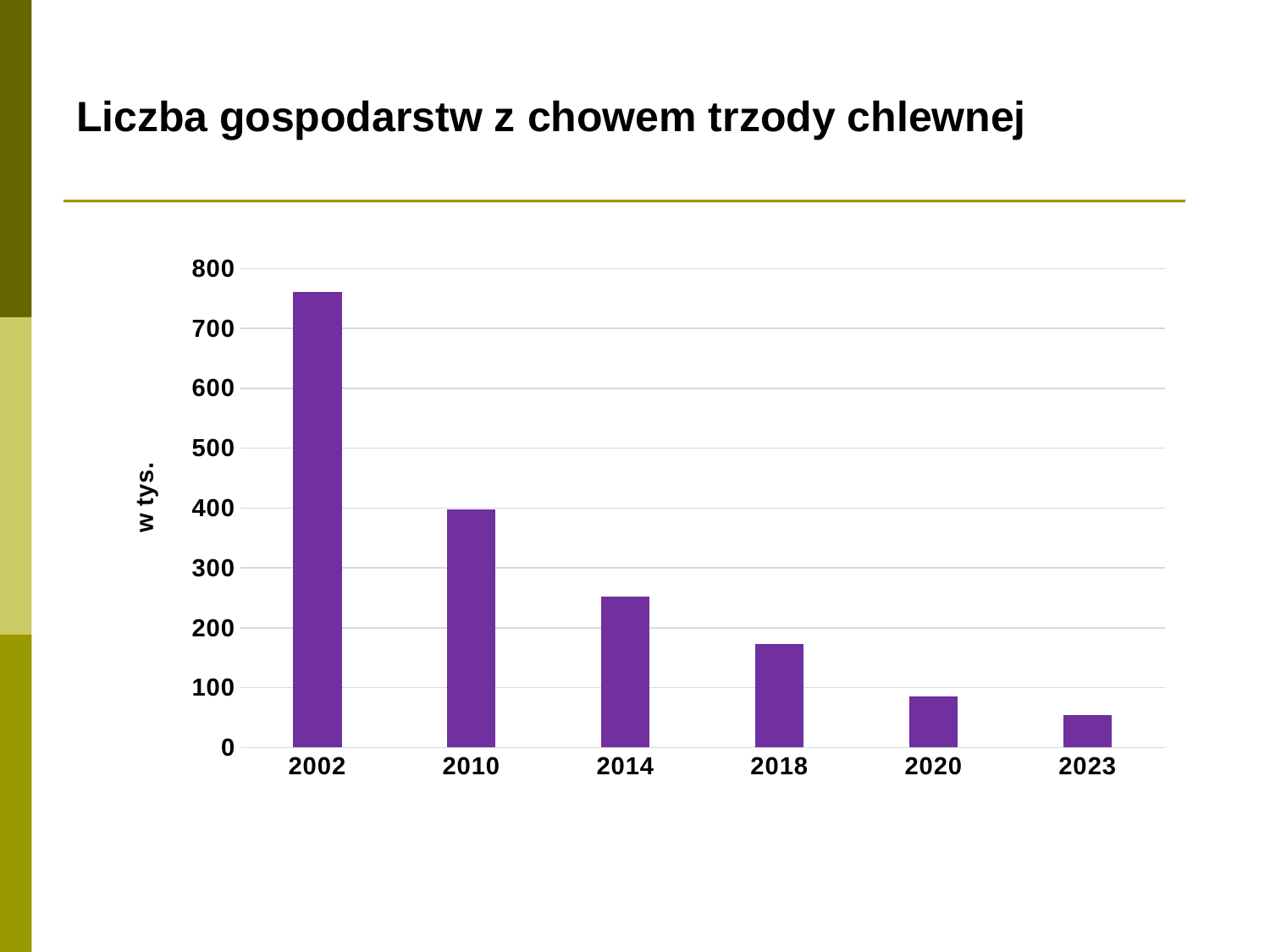
Which is larger, the value for 2010 or the value for 2014? 2010 Is the value for 2002 greater or less than 700? greater What kind of chart is shown on the slide? bar chart Is the value for 2014 greater or less than 300? less Which year has the lowest number of farms? 2023 Is the value for 2020 greater or less than 100? less Do the values rise or fall from 2002 to 2023? fall What is the label on the vertical axis of the chart? w tys. Which year has the highest number of farms? 2002 How many years are shown on the x axis of the chart? 6